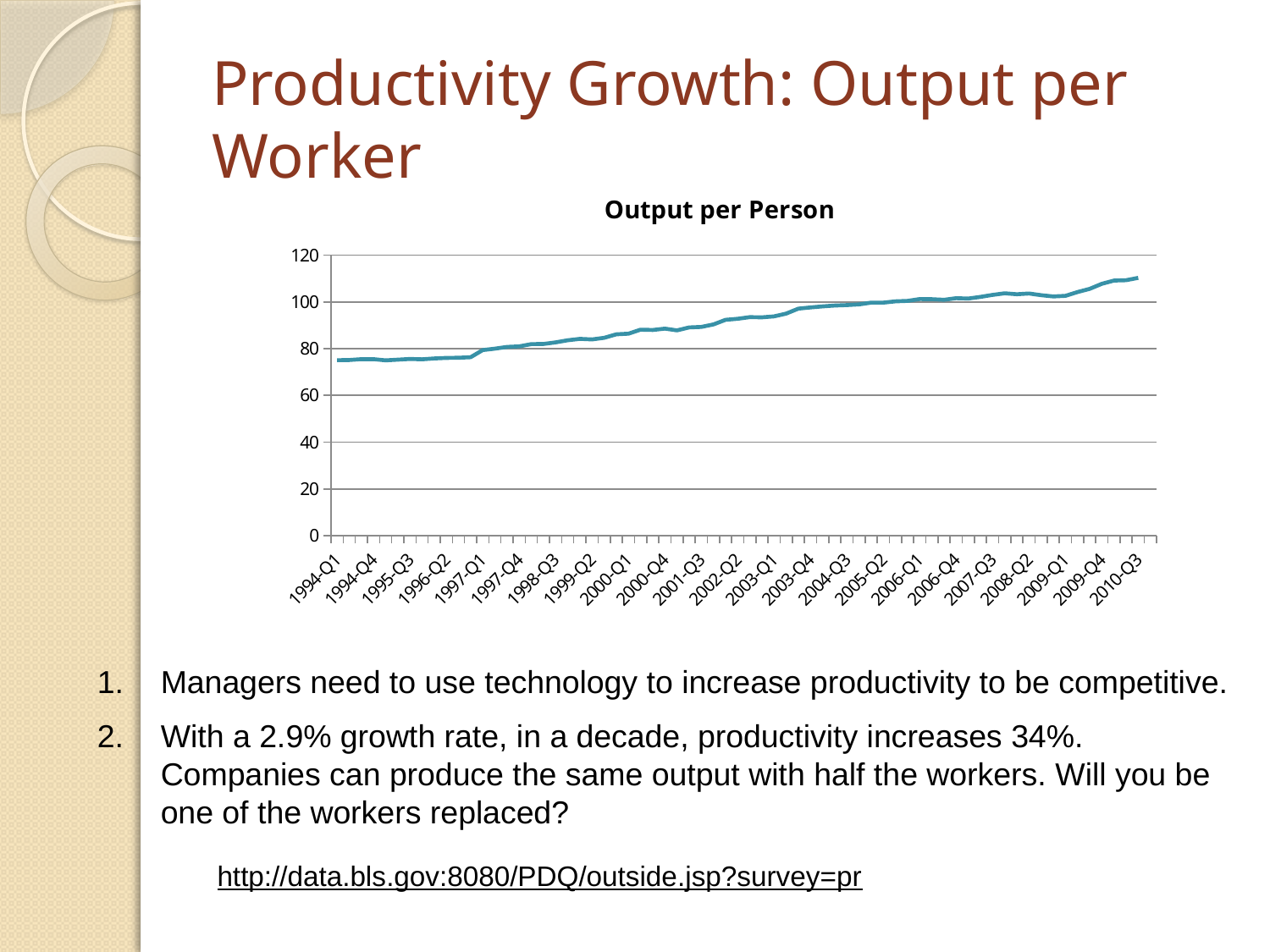
Which is larger, the value for 2010-Q3 or the value for 1994-Q1? 2010-Q3 What is the title of the chart? Output per Person Which quarter has the highest value in the Output per Person chart? 2010-Q3 Do the values in the Output per Person chart generally rise or fall from 1994-Q1 to 2010-Q3? rise Is the value for 2010-Q3 greater or less than 100? greater Is the value for 2008-Q2 greater or less than 100? greater What kind of chart is shown on the slide? line chart Is the value for 1994-Q1 greater or less than 80? less What is the highest value shown on the vertical axis of the chart? 120 Which is larger, the value for 1996-Q2 or the value for 2005-Q2? 2005-Q2